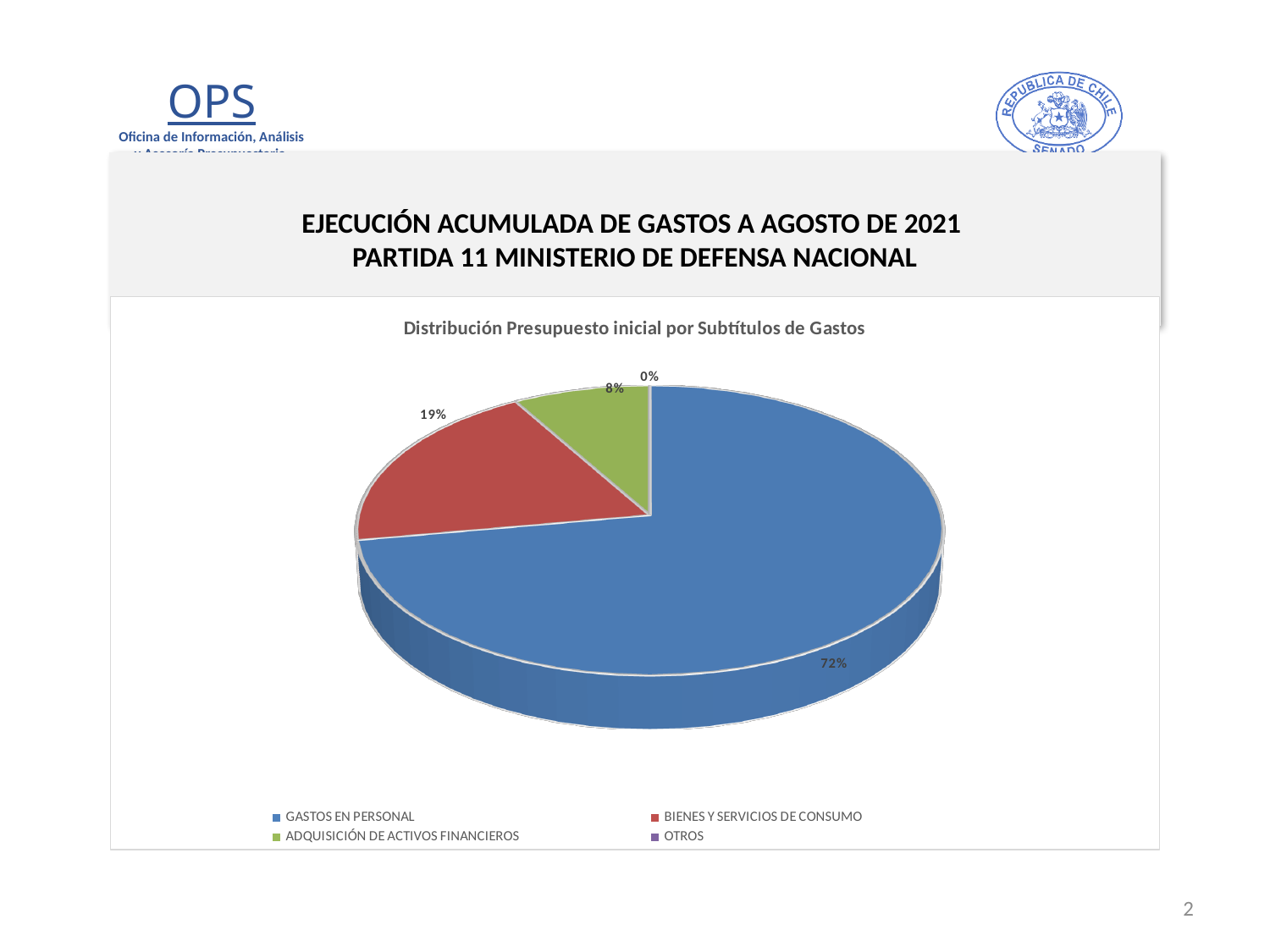
What share of the pie does OTROS represent? 0% What is the difference in percentage points between GASTOS EN PERSONAL and BIENES Y SERVICIOS DE CONSUMO? 53 What share of the pie does BIENES Y SERVICIOS DE CONSUMO represent? 19% What is the title of the chart? Distribución Presupuesto inicial por Subtítulos de Gastos Which category has the smallest share of the pie? OTROS What kind of chart is shown on the slide? Pie chart Which category has the largest share of the pie? GASTOS EN PERSONAL What colour is the slice for BIENES Y SERVICIOS DE CONSUMO? Red What share of the pie does GASTOS EN PERSONAL represent? 72% How many categories does the legend list? 4 Which is larger, the share for BIENES Y SERVICIOS DE CONSUMO or the share for ADQUISICIÓN DE ACTIVOS FINANCIEROS? BIENES Y SERVICIOS DE CONSUMO